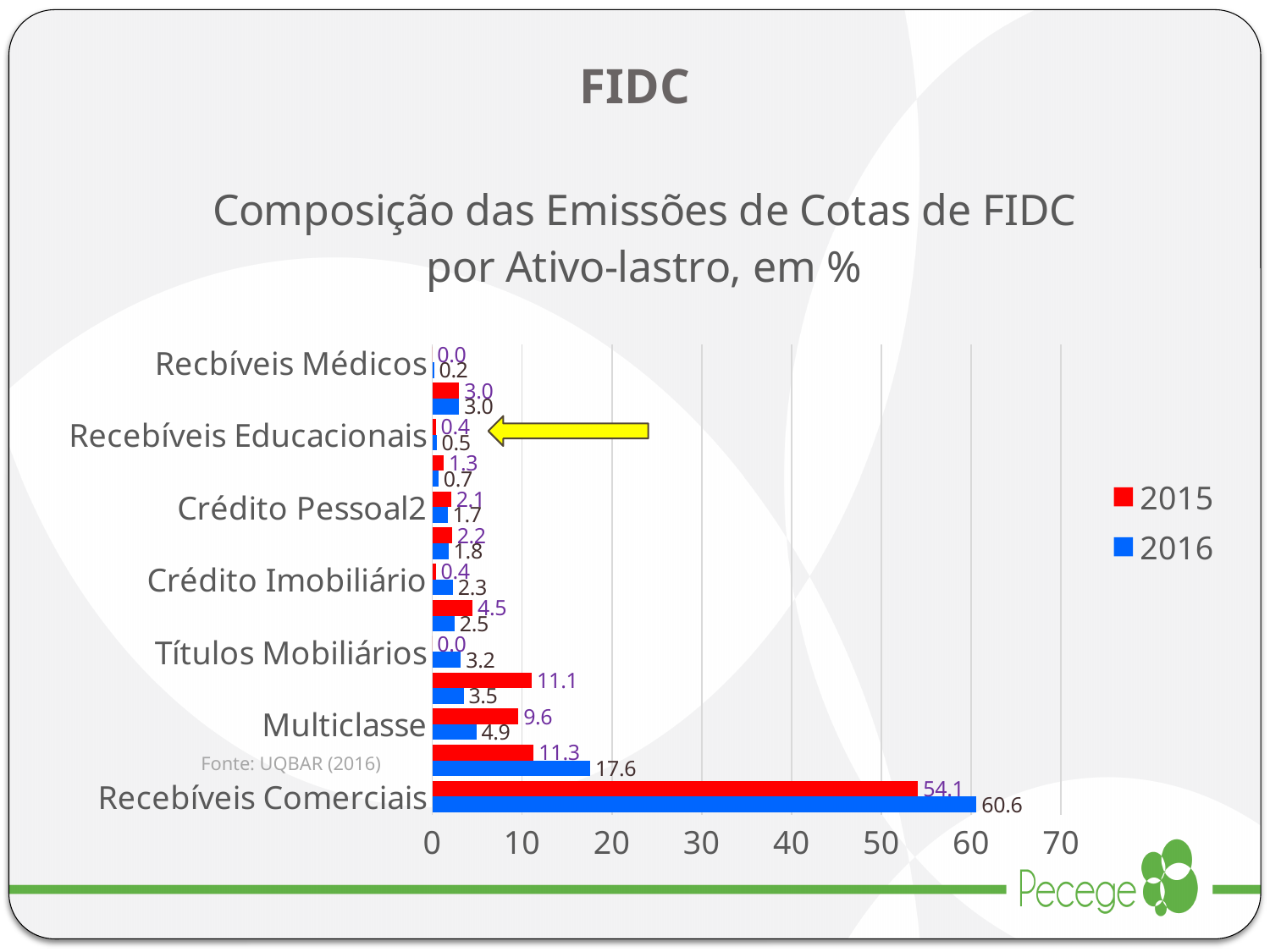
What is the difference between the 2016 and 2015 values for Recebíveis Comerciais? 6.5 How many series does the legend list? 2 For Multiclasse, which year has the larger value, 2015 or 2016? 2015 What is the source cited below the chart? UQBAR (2016) Which category has the highest 2016 value? Recebíveis Comerciais What is the 2016 value for Crédito Imobiliário? 2.3 Which colour represents the 2015 series in the legend? red What is the 2016 value for Recebíveis Comerciais? 60.6 What is the 2015 value for Recebíveis Comerciais? 54.1 What is the 2016 value for Títulos Mobiliários? 3.2 What type of chart is shown on the slide? bar chart What is the 2015 value for Multiclasse? 9.6